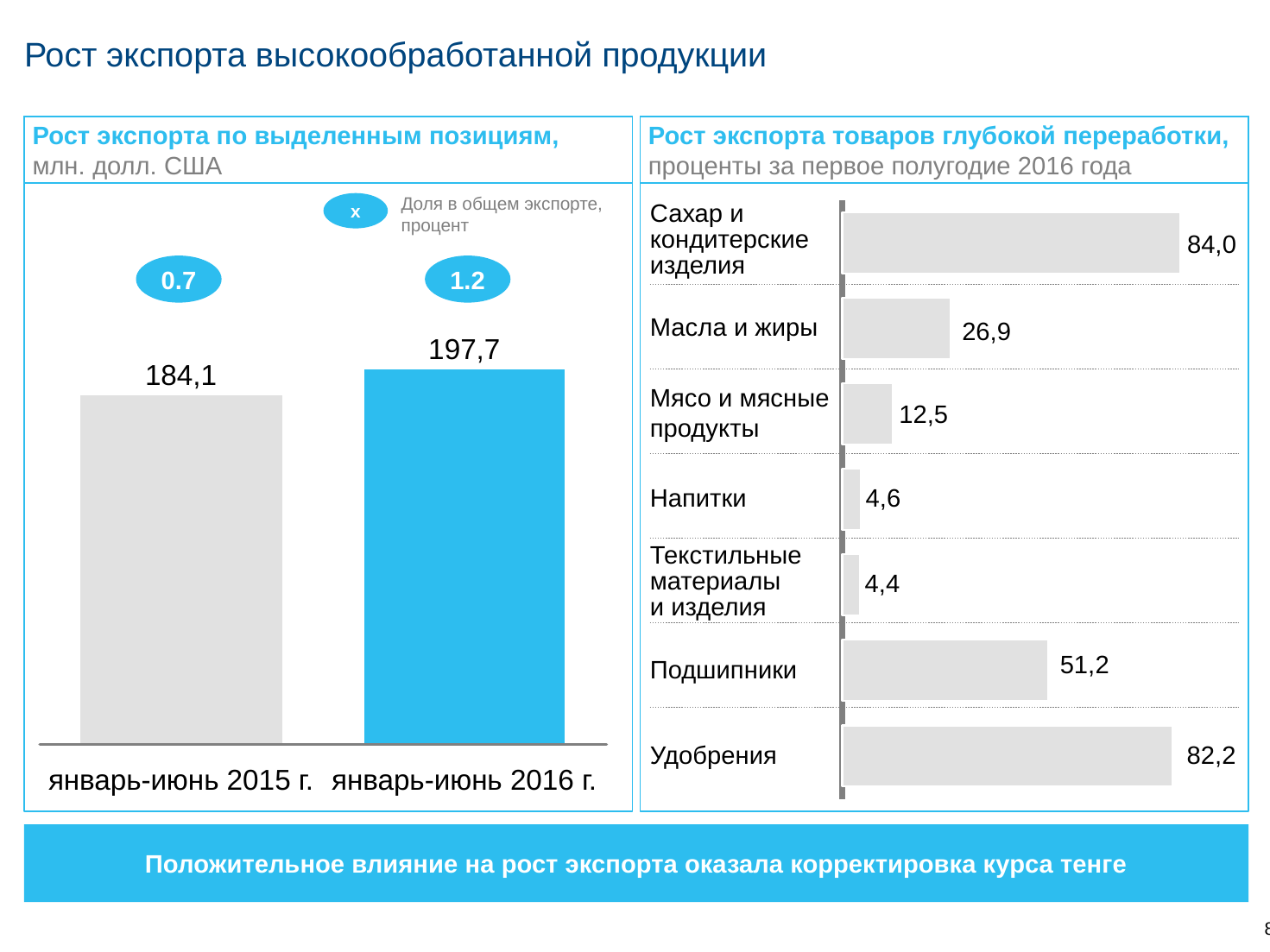
In the chart 'Рост экспорта по выделенным позициям', what share of total export (процент) is shown above the январь-июнь 2016 г. bar? 1.2 In the chart 'Рост экспорта по выделенным позициям', what is the value for январь-июнь 2015 г.? 184,1 In the chart 'Рост экспорта товаров глубокой переработки', what is the value for Подшипники? 51,2 In the chart 'Рост экспорта товаров глубокой переработки', how many categories are shown? 7 In the chart 'Рост экспорта товаров глубокой переработки', what is the difference between Сахар и кондитерские изделия and Удобрения? 1,8 In the chart 'Рост экспорта по выделенным позициям', by how much does the value for январь-июнь 2016 г. exceed the value for январь-июнь 2015 г.? 13,6 In the chart 'Рост экспорта товаров глубокой переработки', which category has the lowest value? Текстильные материалы и изделия In the chart 'Рост экспорта товаров глубокой переработки', what is the value for Масла и жиры? 26,9 In the chart 'Рост экспорта по выделенным позициям', do the values rise or fall from январь-июнь 2015 г. to январь-июнь 2016 г.? rise In the chart 'Рост экспорта товаров глубокой переработки', which category has the highest value? Сахар и кондитерские изделия In the chart 'Рост экспорта по выделенным позициям', what is the value for январь-июнь 2016 г.? 197,7 What kind of chart is 'Рост экспорта товаров глубокой переработки'? bar chart